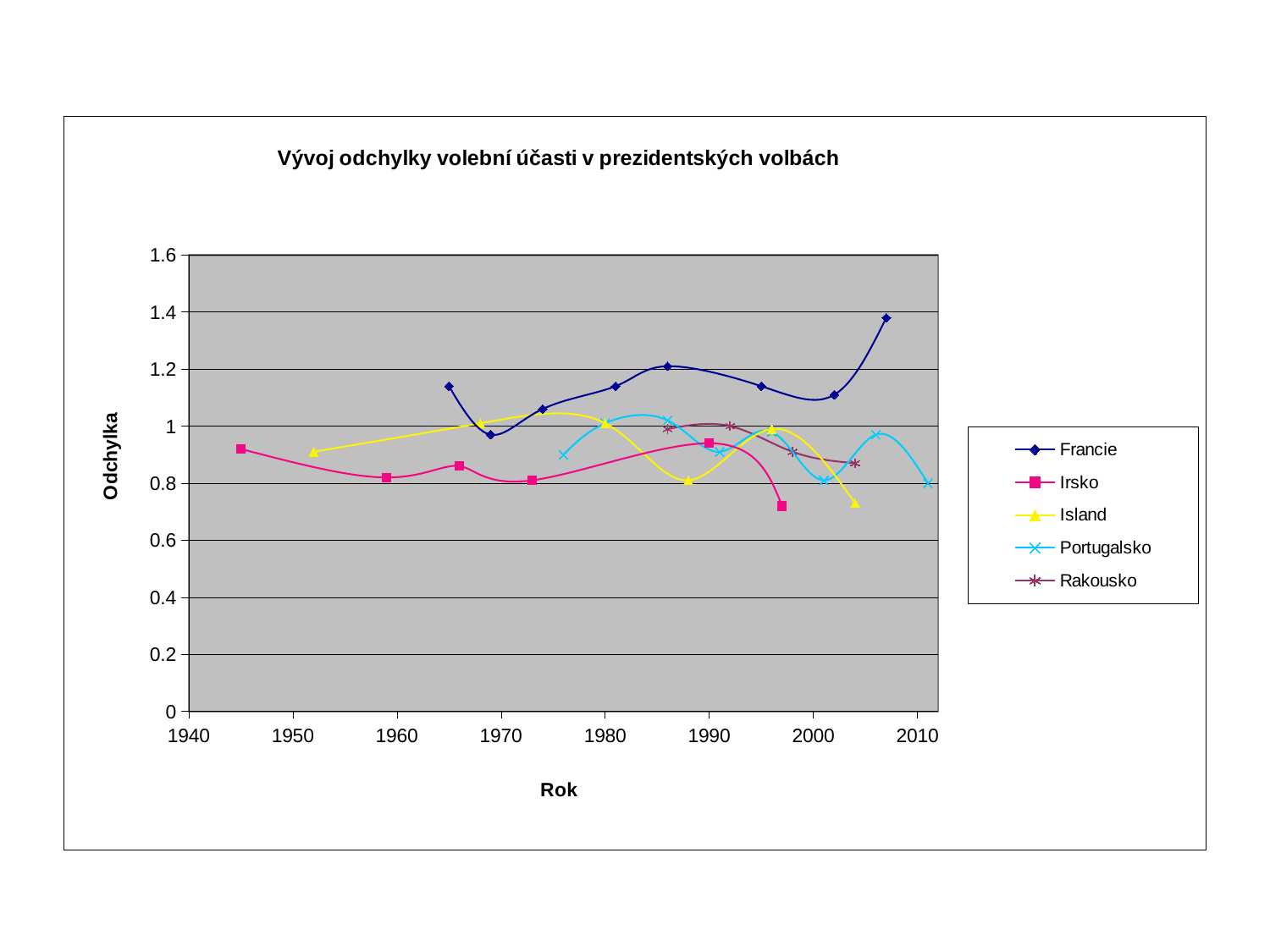
Which series reaches the highest value on the chart? Francie What is the label of the horizontal axis? Rok Is the value for Francie at its last point (around 2007) greater or less than 1.2? greater Is the value for Rakousko at its last point (around 2004) greater or less than 1? less What kind of chart is shown on the slide? line chart Does the Irsko series rise or fall between 1990 and 1997? fall Is the value for Island at its last point (around 2004) greater or less than 0.8? less Which is larger: the last value for Francie or the last value for Irsko? Francie What is the title of the chart? Vývoj odchylky volební účasti v prezidentských volbách How many data points does the Rakousko series have? 4 How many series does the legend list? 5